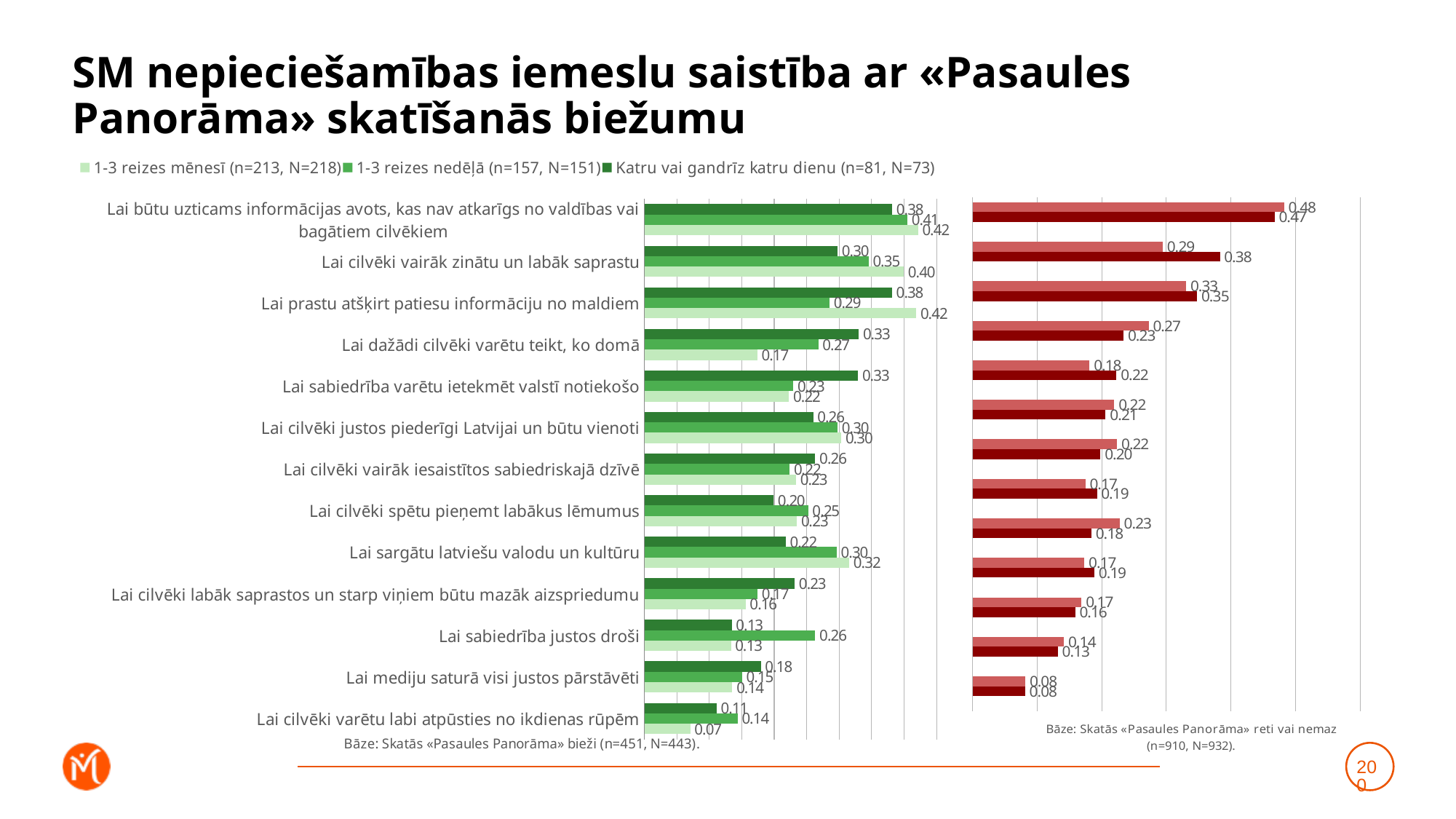
What is the sample size stated in the legend for the '1-3 reizes mēnesī' series? n=213, N=218 On the right (red) chart, what is the value of the top bar for 'Lai būtu uzticams informācijas avots, kas nav atkarīgs no valdības vai bagātiem cilvēkiem'? 0.48 What type of chart is used on this slide? Bar chart How many categories are shown on the left (green) chart? 13 How many series does the legend of the left (green) chart list? 3 On the left (green) chart, what is the value for 'Lai dažādi cilvēki varētu teikt, ko domā' in the 'Katru vai gandrīz katru dienu' series? 0.33 On the left (green) chart, which category has the highest value in the 'Katru vai gandrīz katru dienu' series? Two categories tie at 0.38: 'Lai būtu uzticams informācijas avots, kas nav atkarīgs no valdības vai bagātiem cilvēkiem' and 'Lai prastu atšķirt patiesu informāciju no maldiem' On the left (green) chart, what is the value for 'Lai cilvēki varētu labi atpūsties no ikdienas rūpēm' in the '1-3 reizes mēnesī' series? 0.07 On the left (green) chart, what is the difference between the '1-3 reizes mēnesī' and 'Katru vai gandrīz katru dienu' values for 'Lai dažādi cilvēki varētu teikt, ko domā'? 0.16 On the left (green) chart, for 'Lai prastu atšķirt patiesu informāciju no maldiem', which is larger: the '1-3 reizes nedēļā' value or the 'Katru vai gandrīz katru dienu' value? Katru vai gandrīz katru dienu On the left (green) chart, which category has the lowest value in the '1-3 reizes mēnesī' series? Lai cilvēki varētu labi atpūsties no ikdienas rūpēm On the left (green) chart, what is the value for 'Lai sabiedrība justos droši' in the '1-3 reizes nedēļā' series? 0.26